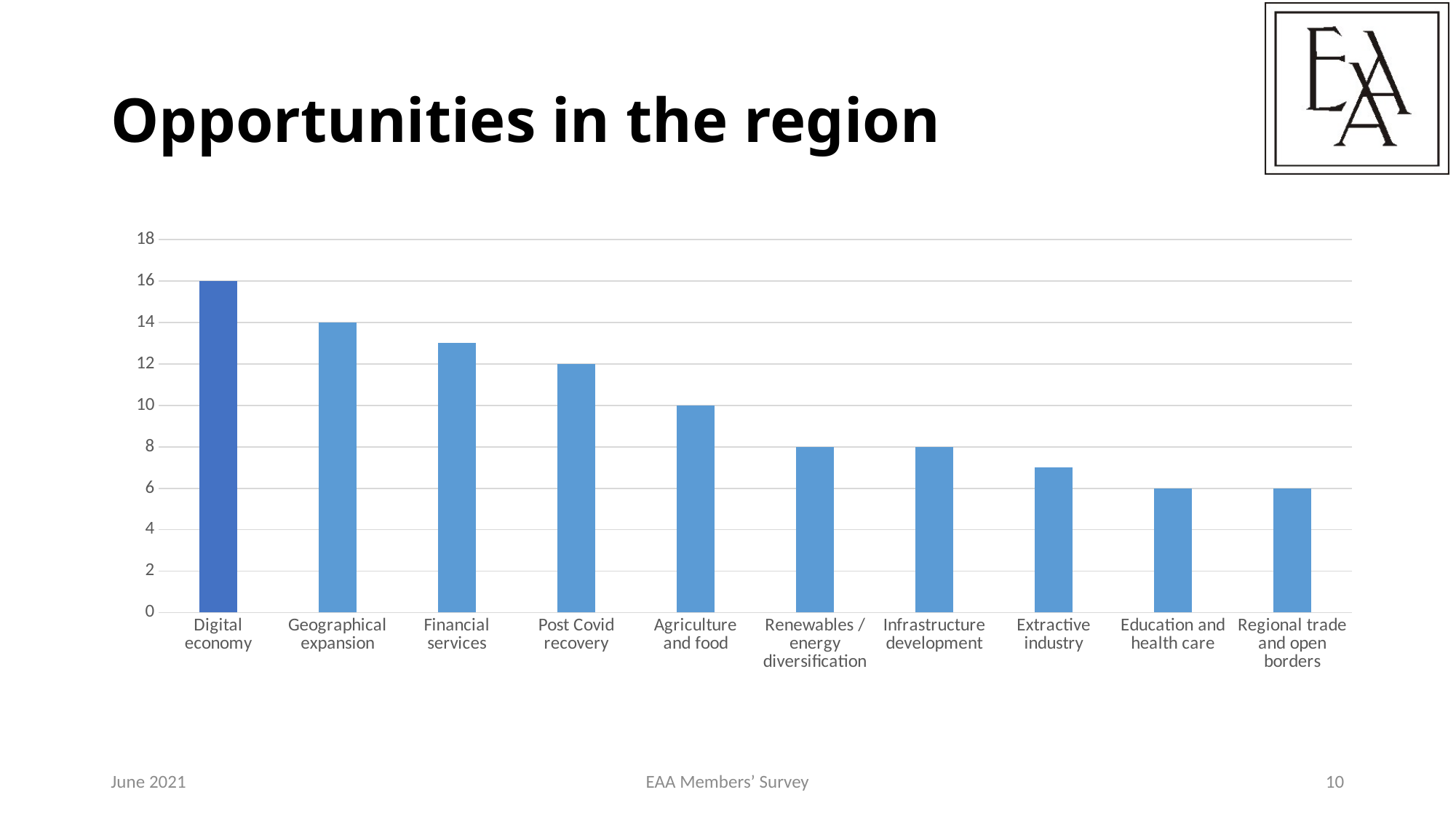
Which is larger, the value for Geographical expansion or the value for Post Covid recovery? Geographical expansion Which category has the highest value in the chart? Digital economy Do the values rise or fall from left to right along the x axis? Fall How many categories are shown on the x axis of the chart? 10 Is the value for Extractive industry greater or less than 8? less What is the value for Post Covid recovery? 12 What is the difference between the values for Digital economy and Geographical expansion? 2 What is the value for Geographical expansion? 14 Is the value for Financial services greater or less than 12? greater What is the value for Agriculture and food? 10 What is the value for Digital economy? 16 What type of chart is shown on the slide? Bar chart